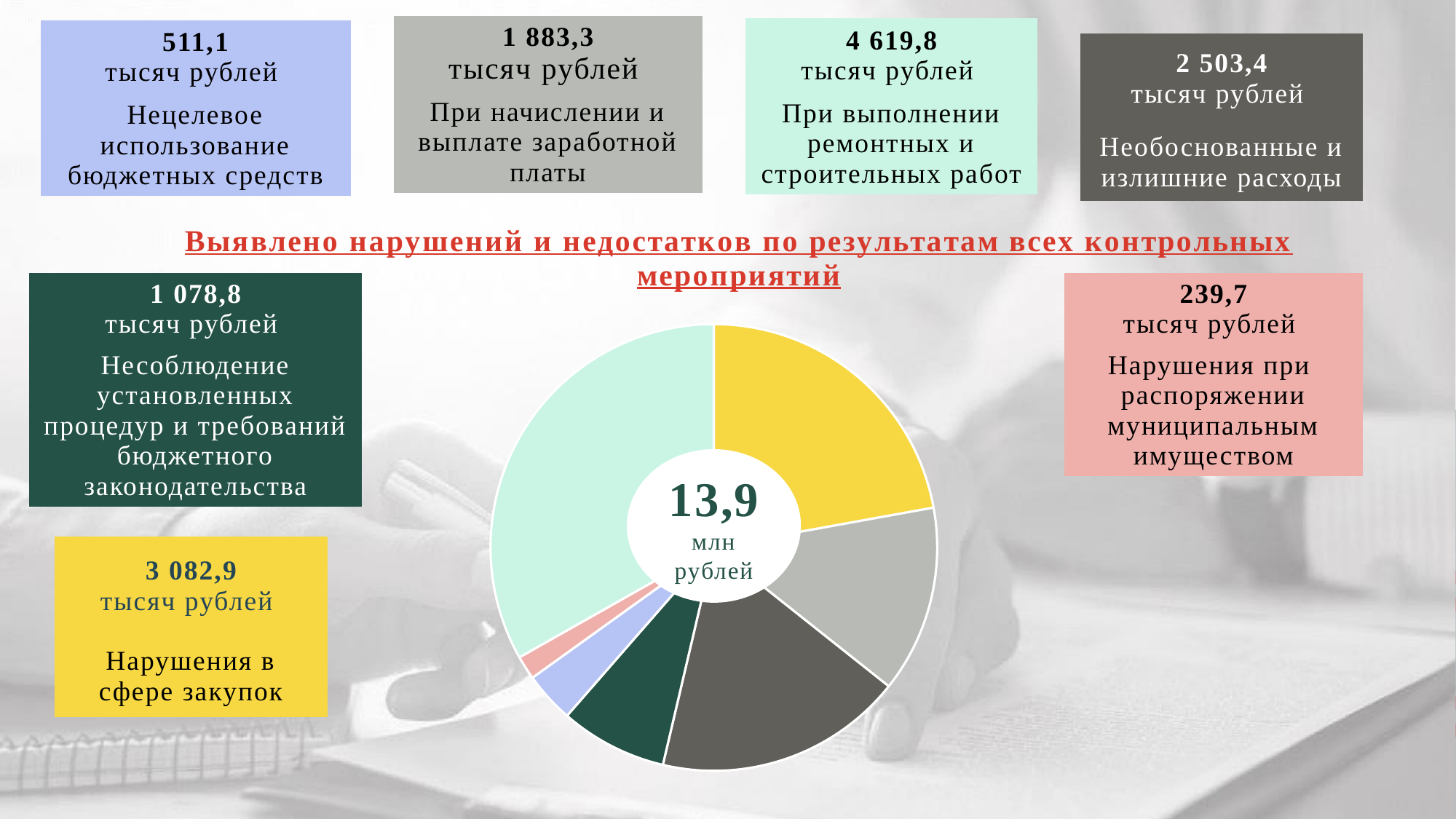
What is the title above the pie chart? Выявлено нарушений и недостатков по результатам всех контрольных мероприятий How many slices does the pie chart have? 7 Which category has the largest slice of the pie chart? При выполнении ремонтных и строительных работ What is the value for 'Необоснованные и излишние расходы'? 2 503,4 тысяч рублей What kind of chart is shown on the slide? Pie chart (donut) What colour is the slice for 'Нарушения в сфере закупок'? Yellow What is the value for 'Нарушения в сфере закупок'? 3 082,9 тысяч рублей What is the difference between 'При выполнении ремонтных и строительных работ' and 'Нарушения в сфере закупок'? 1 536,9 тысяч рублей Which category has the smallest slice of the pie chart? Нарушения при распоряжении муниципальным имуществом What total value is printed in the centre of the pie chart? 13,9 млн рублей Which is larger: 'При начислении и выплате заработной платы' or 'Несоблюдение установленных процедур и требований бюджетного законодательства'? При начислении и выплате заработной платы What is the value for 'Нецелевое использование бюджетных средств'? 511,1 тысяч рублей